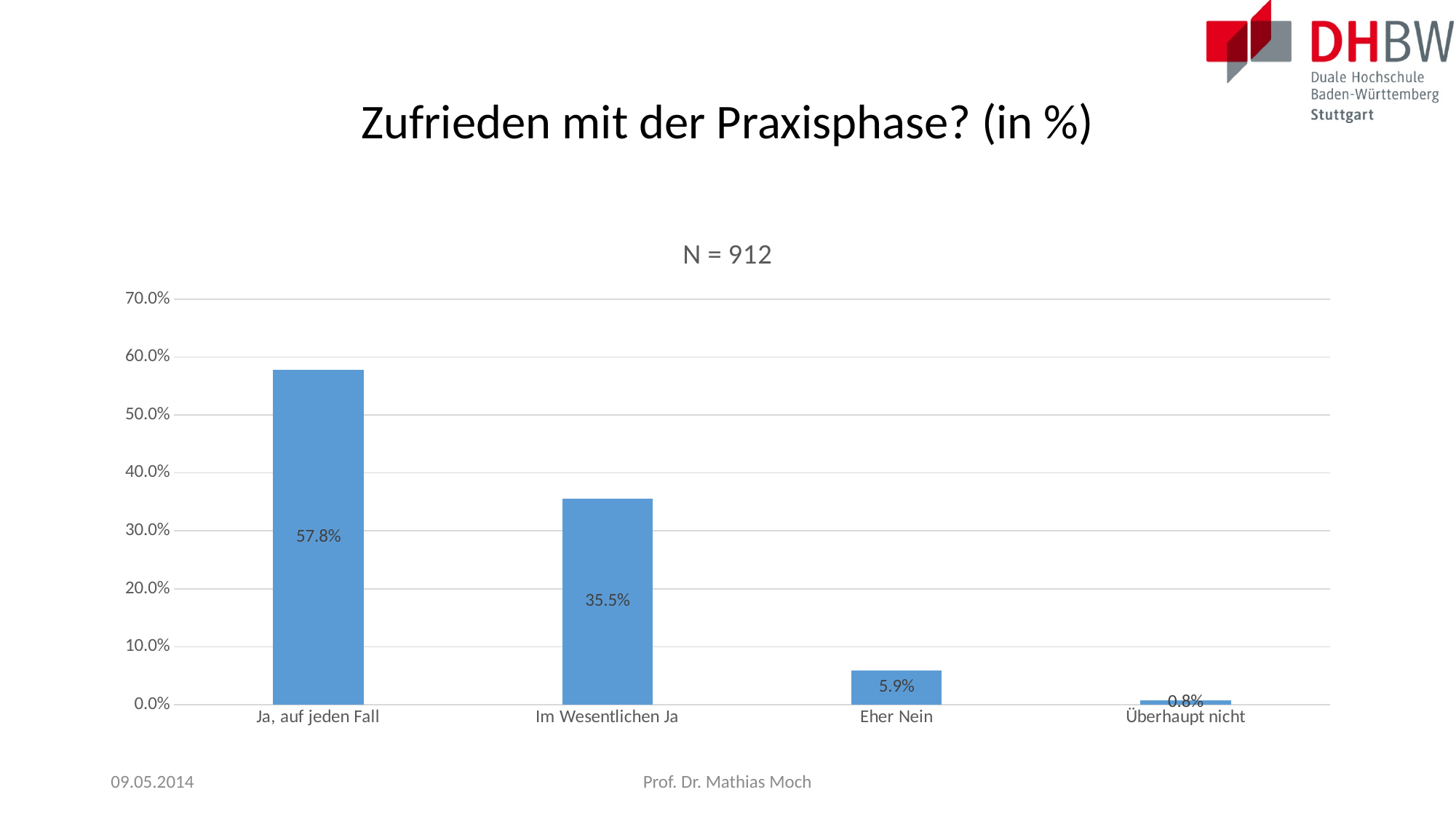
Which is larger, the value for "Eher Nein" or the value for "Überhaupt nicht"? Eher Nein What sample size (N) is stated above the chart? N = 912 Which category has the lowest value? Überhaupt nicht Which category has the highest value? Ja, auf jeden Fall What is the value for "Eher Nein"? 5.9% What is the value for "Überhaupt nicht"? 0.8% How many categories are shown on the x axis? 4 What is the value for "Ja, auf jeden Fall"? 57.8% What kind of chart is shown on the slide? bar chart What is the difference between the values for "Ja, auf jeden Fall" and "Im Wesentlichen Ja"? 22.3% What is the value for "Im Wesentlichen Ja"? 35.5% Is the value for "Im Wesentlichen Ja" greater or less than 40.0%? less